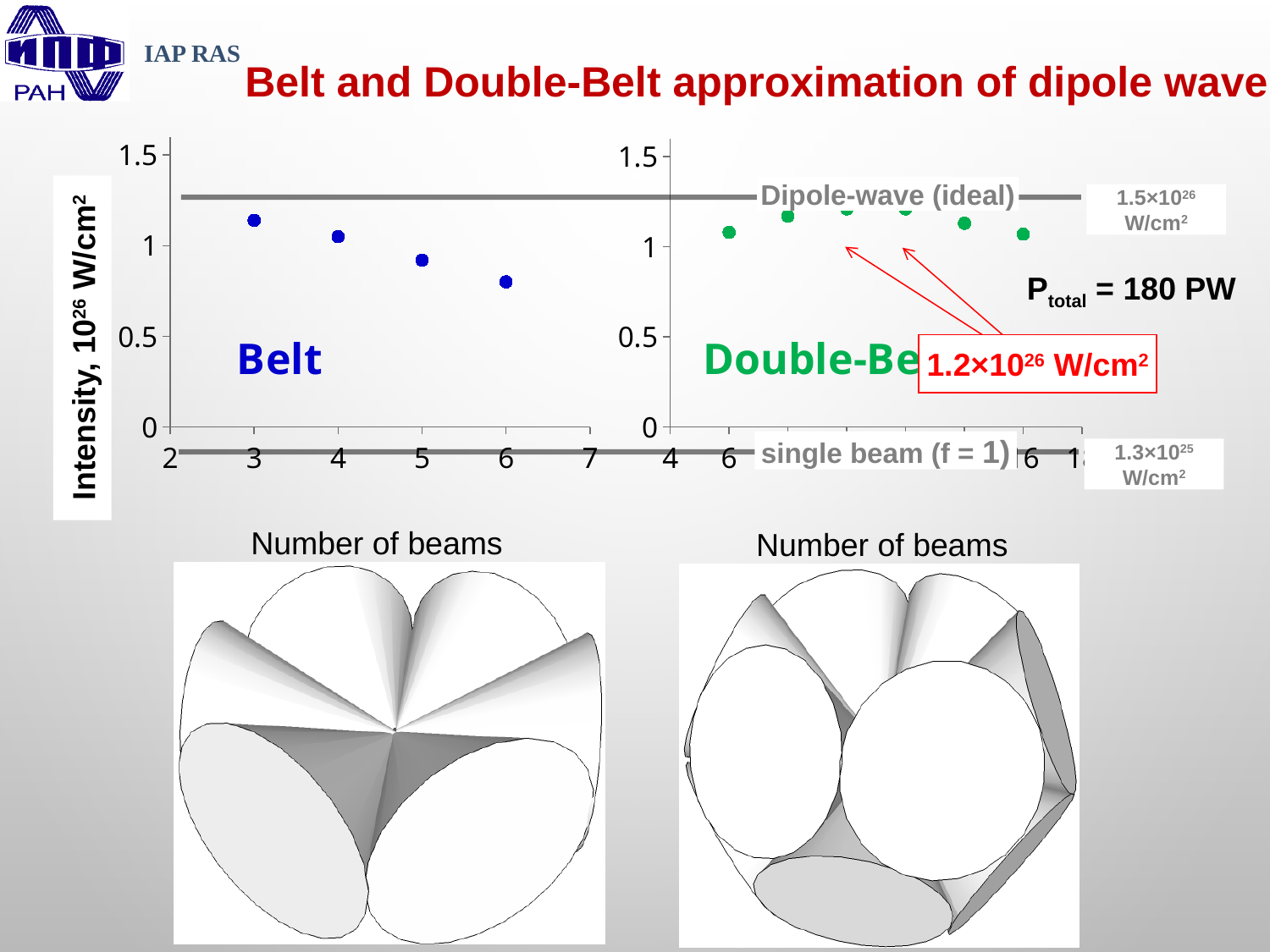
What is the label of the x axis on both charts? Number of beams In the Belt chart, which number of beams gives the lowest intensity? 6 In the Belt chart, is the intensity for 3 beams greater or less than 1? greater What kind of chart is the Belt chart on the left? scatter chart In the Double-Belt chart, is the intensity for 6 beams greater or less than 1? greater In the Belt chart, is the intensity for 6 beams greater or less than 1? less What intensity value is given for the Dipole-wave (ideal) line? 1.5×10²⁶ W/cm² Which is larger: the intensity for 6 beams in the Belt chart or the intensity for 6 beams in the Double-Belt chart? Double-Belt In the Belt chart, do the intensity values rise or fall as the number of beams increases? fall In the Belt chart, which number of beams gives the highest intensity? 3 In the Belt chart, how many data points are plotted? 4 In the Double-Belt chart, how many data points are plotted? 6